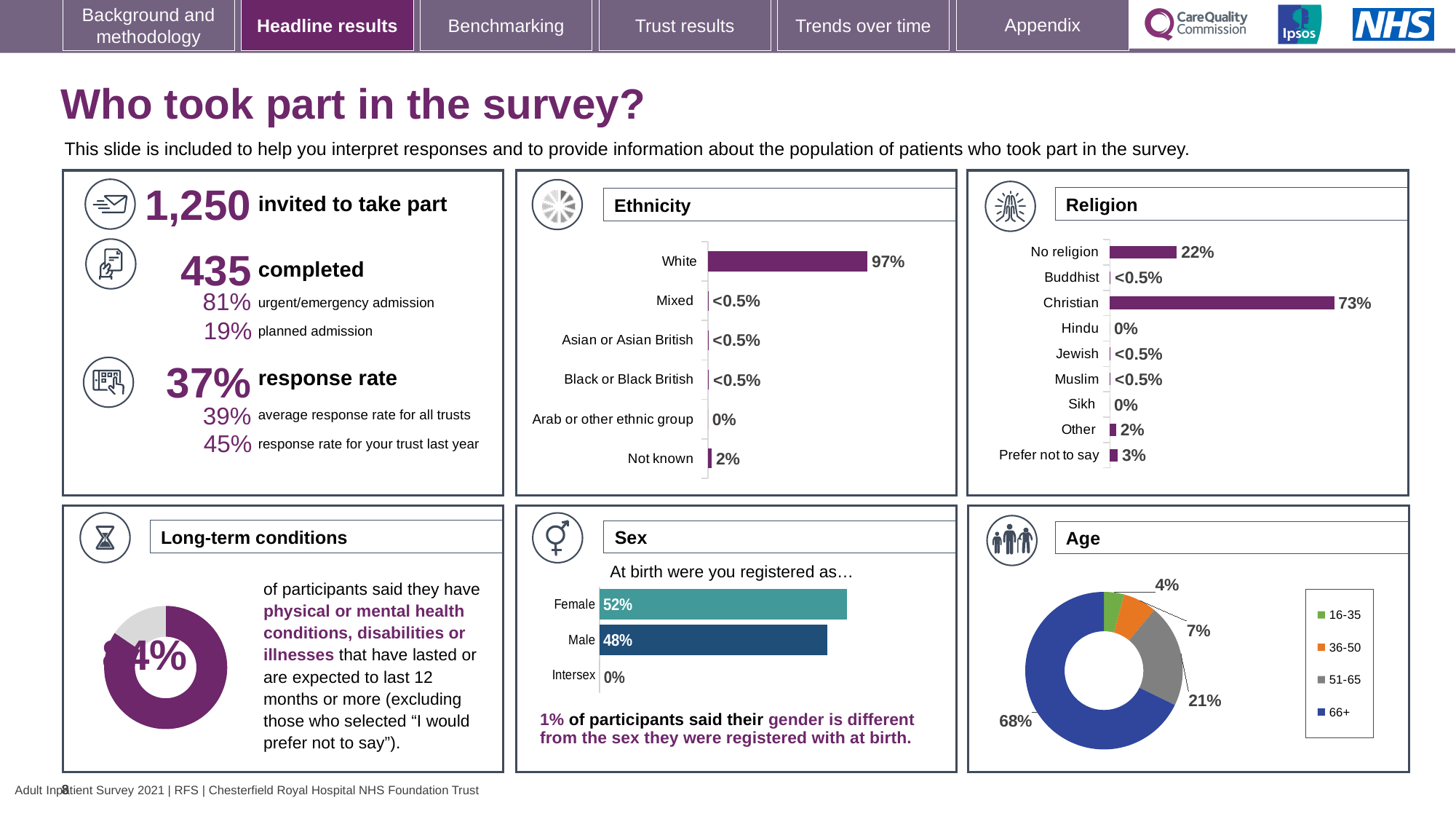
In the Religion chart, what is the difference between the Christian and No religion values? 51% How many categories are shown in the Ethnicity chart? 6 In the Religion chart, which is larger, Other or Prefer not to say? Prefer not to say In the Sex chart, what percentage of participants were registered as Female at birth? 52% In the Religion chart, what percentage of participants were Christian? 73% In the Age chart, what share of participants were aged 66+? 68% In the Ethnicity chart, which category has the highest value? White In the Ethnicity chart, what is the value for Not known? 2% In the Sex chart, what is the difference between the Female and Male values? 4% In the Religion chart, what is the value for No religion? 22% What type of chart is the Age chart? Doughnut chart In the Ethnicity chart, what percentage of participants were White? 97%